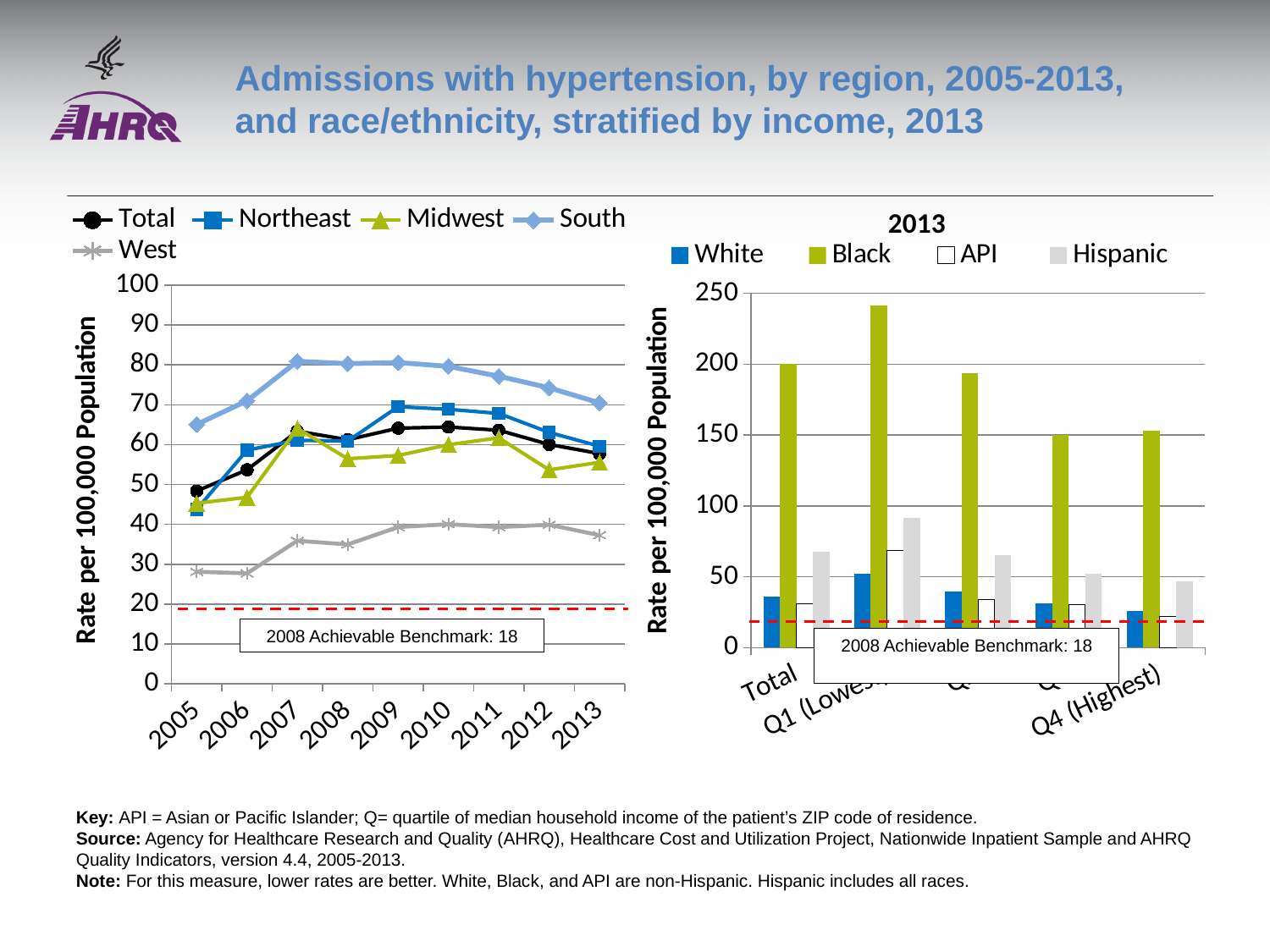
In the left chart (by region), which region has the highest rate in 2013? South In the right chart (2013), is the value for Black in Q1 (Lowest) greater or less than 200? greater What kind of chart is the right chart titled 2013? bar chart In the left chart (by region), is the value for West in 2005 greater or less than 30? less How many series does the legend of the right chart (2013) list? 4 In the left chart (by region), which region has the lowest rate in 2013? West In the left chart (by region), is the value for South in 2009 greater or less than 70? greater How many years are plotted on the x axis of the left chart (by region)? 9 What kind of chart is the left chart showing admissions by region, 2005-2013? line chart In the right chart (2013), which race/ethnicity has the highest rate in Q1 (Lowest)? Black How many series does the legend of the left chart (by region) list? 5 What is the 2008 Achievable Benchmark shown on both charts? 18